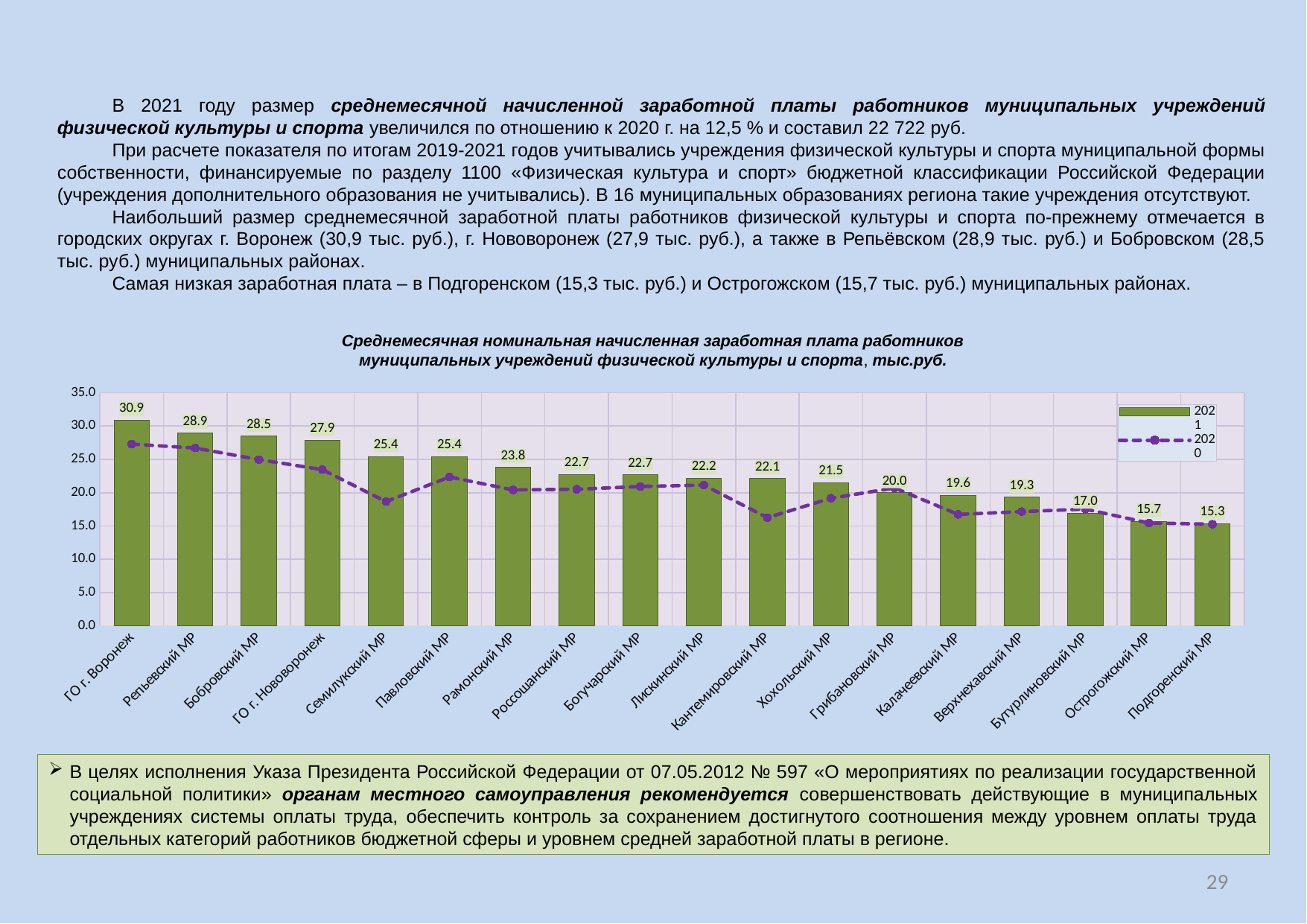
What is the 2021 value for Бутурлиновский МР? 17.0 Is the 2020 value for Семилукский МР greater or less than 20.0? less Which category has the lowest 2021 value? Подгоренский МР Which has a larger 2021 value, Рамонский МР or Грибановский МР? Рамонский МР What is the 2021 value for Репьевский МР? 28.9 What is the 2021 value for Хохольский МР? 21.5 Which category has the highest 2021 value? ГО г. Воронеж How many series does the legend list? 2 Is the 2020 value for ГО г. Воронеж greater or less than 25.0? greater How many categories are shown on the x axis? 18 What is the difference between the 2021 values for ГО г. Воронеж and Подгоренский МР? 15.6 Do the 2021 bar values rise or fall from left to right along the x axis? fall